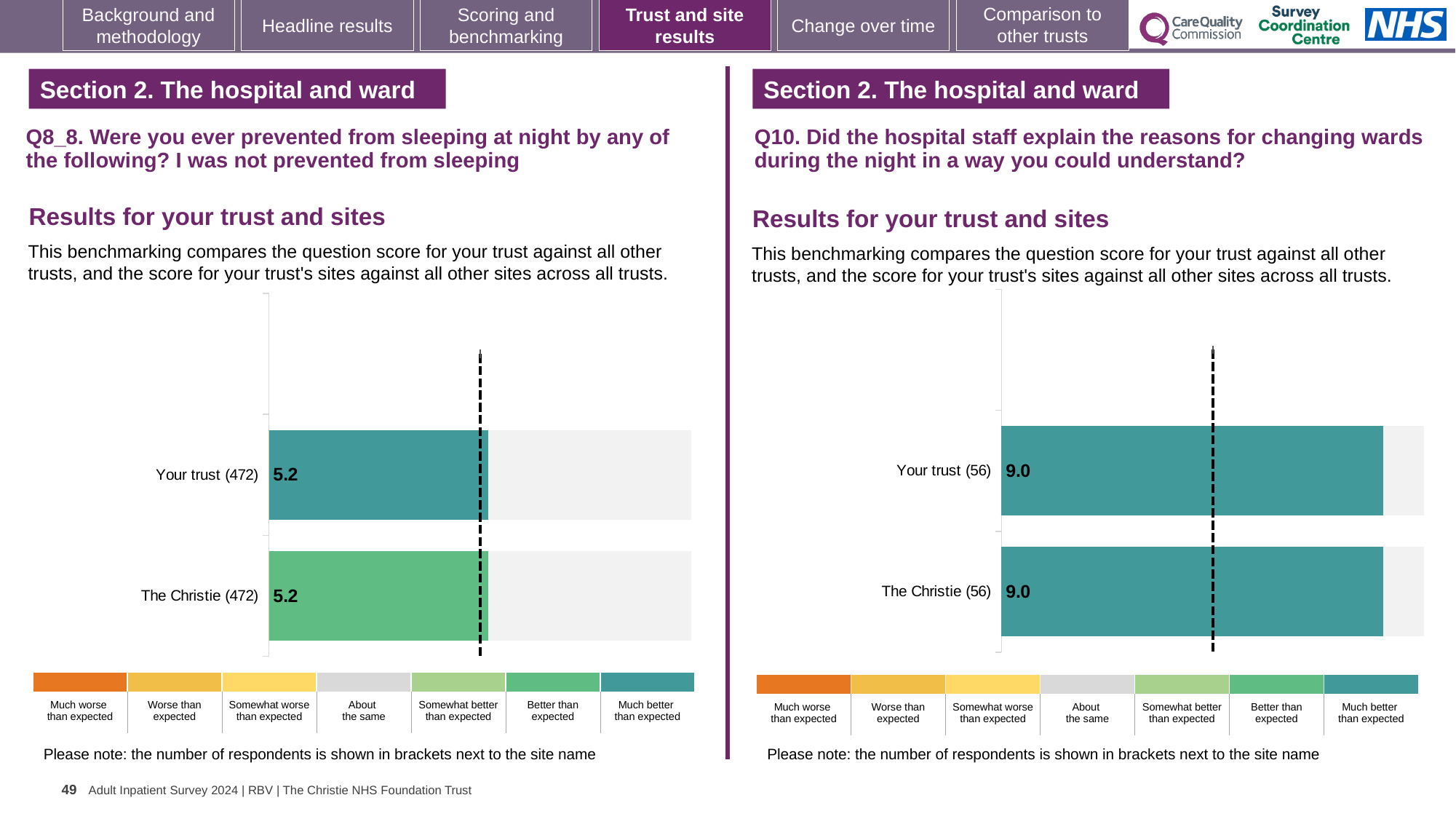
On the Q8_8 chart (left), what is the difference between the Your trust score and The Christie score? 0.0 How many bars are plotted on the Q10 chart (right)? 2 On the Q8_8 chart (left), which benchmark category does the colour of The Christie bar correspond to in the key? Better than expected On the Q8_8 chart (left), what is the score for The Christie? 5.2 On the Q10 chart (right), what is the score for Your trust? 9.0 On the Q10 chart (right), how many respondents are shown in brackets for The Christie? 56 On the Q8_8 chart (left), which benchmark category does the colour of the Your trust bar correspond to in the key? Much better than expected On the Q10 chart (right), what is the difference between the Your trust score and The Christie score? 0.0 On the Q8_8 chart (left), how many respondents are shown in brackets for Your trust? 472 On the Q8_8 chart (left), what is the score for Your trust? 5.2 What kind of chart is used on the Q8_8 chart (left)? Bar chart On the Q10 chart (right), what is the score for The Christie? 9.0